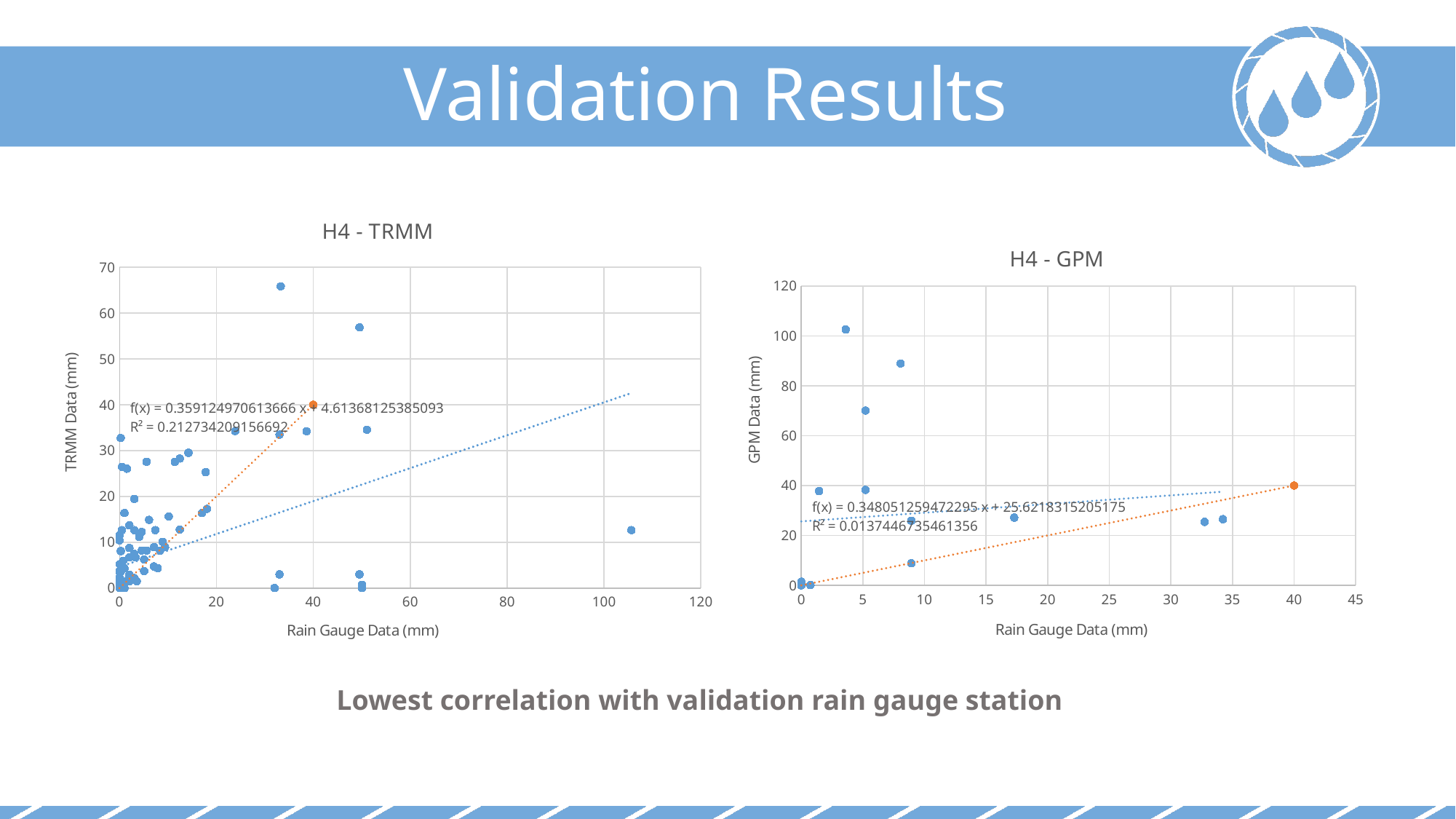
In the "H4 - TRMM" chart, is the TRMM value of the highest point greater or less than 60? greater In the "H4 - TRMM" chart, what is the trendline equation printed on the chart? f(x) = 0.359124970613666 x + 4.61368125385093 Which chart has the higher R² value, "H4 - TRMM" or "H4 - GPM"? H4 - TRMM What kind of chart is the "H4 - TRMM" chart? scatter chart In the "H4 - TRMM" chart, what is the R² value printed on the chart? R² = 0.212734209156692 How many charts are shown on the slide? 2 In the "H4 - GPM" chart, what is the trendline equation printed on the chart? f(x) = 0.348051259472295 x + 25.6218315205175 In the "H4 - GPM" chart, what is the R² value printed on the chart? R² = 0.0137446735461356 What is the title of the chart on the right? H4 - GPM In the "H4 - TRMM" chart, is the TRMM value of the point with the largest rain gauge value (just over 100 mm) greater or less than 20? less In the "H4 - GPM" chart, is the GPM value of the highest point greater or less than 90? greater What is the y-axis label of the "H4 - GPM" chart? GPM Data (mm)